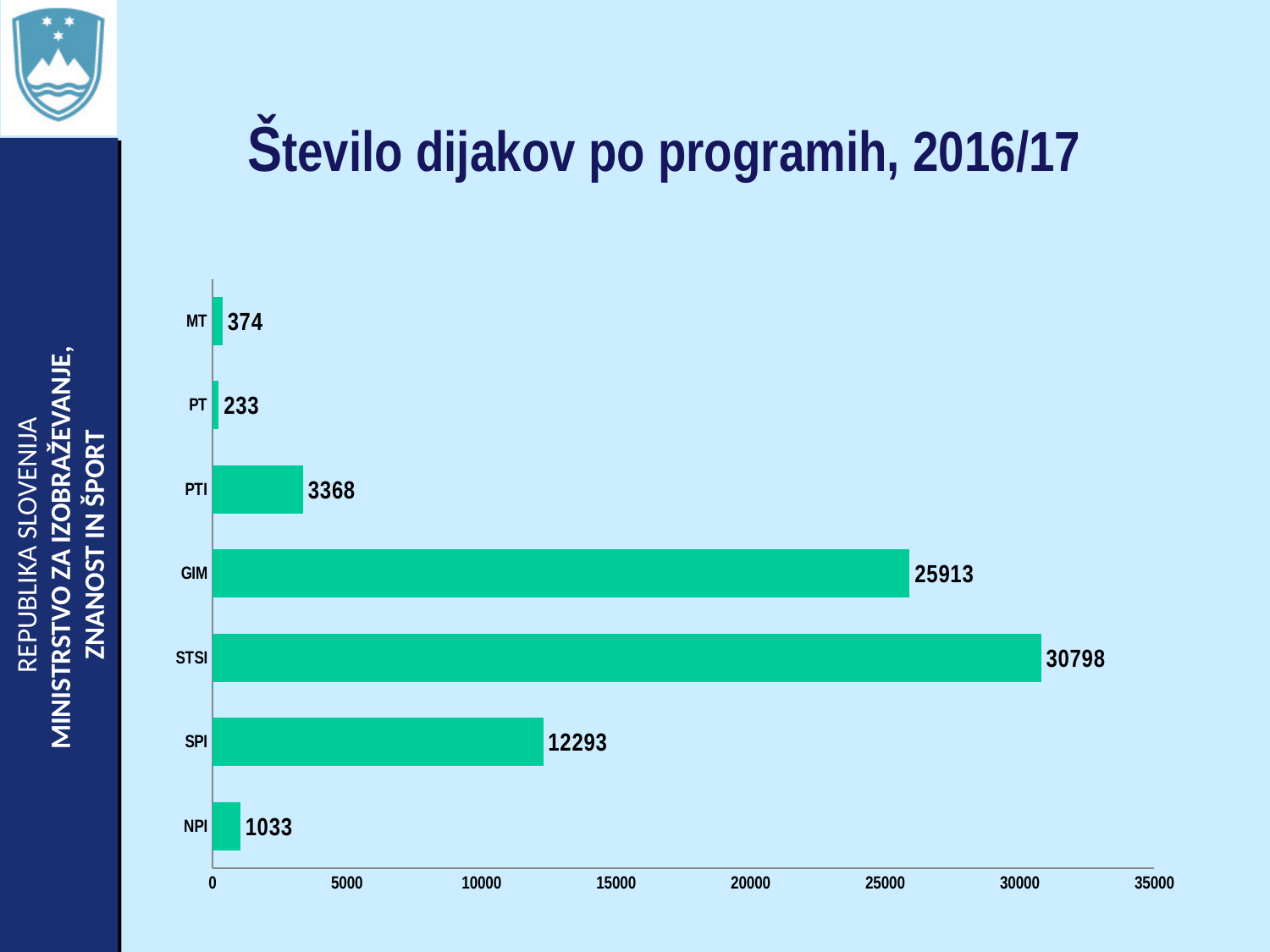
What is the value for GIM? 25913 Which program has the highest number of students? STSI What is the title of the chart? Število dijakov po programih, 2016/17 What is the value for NPI? 1033 Which is larger, the value for SPI or the value for PTI? SPI What kind of chart is shown on the slide? bar chart How many programs are shown in the chart? 7 Is the value for SPI greater or less than 10000? greater Which program has the lowest number of students? PT What is the value for PT? 233 What is the value for STSI? 30798 What is the difference between the values for STSI and GIM? 4885